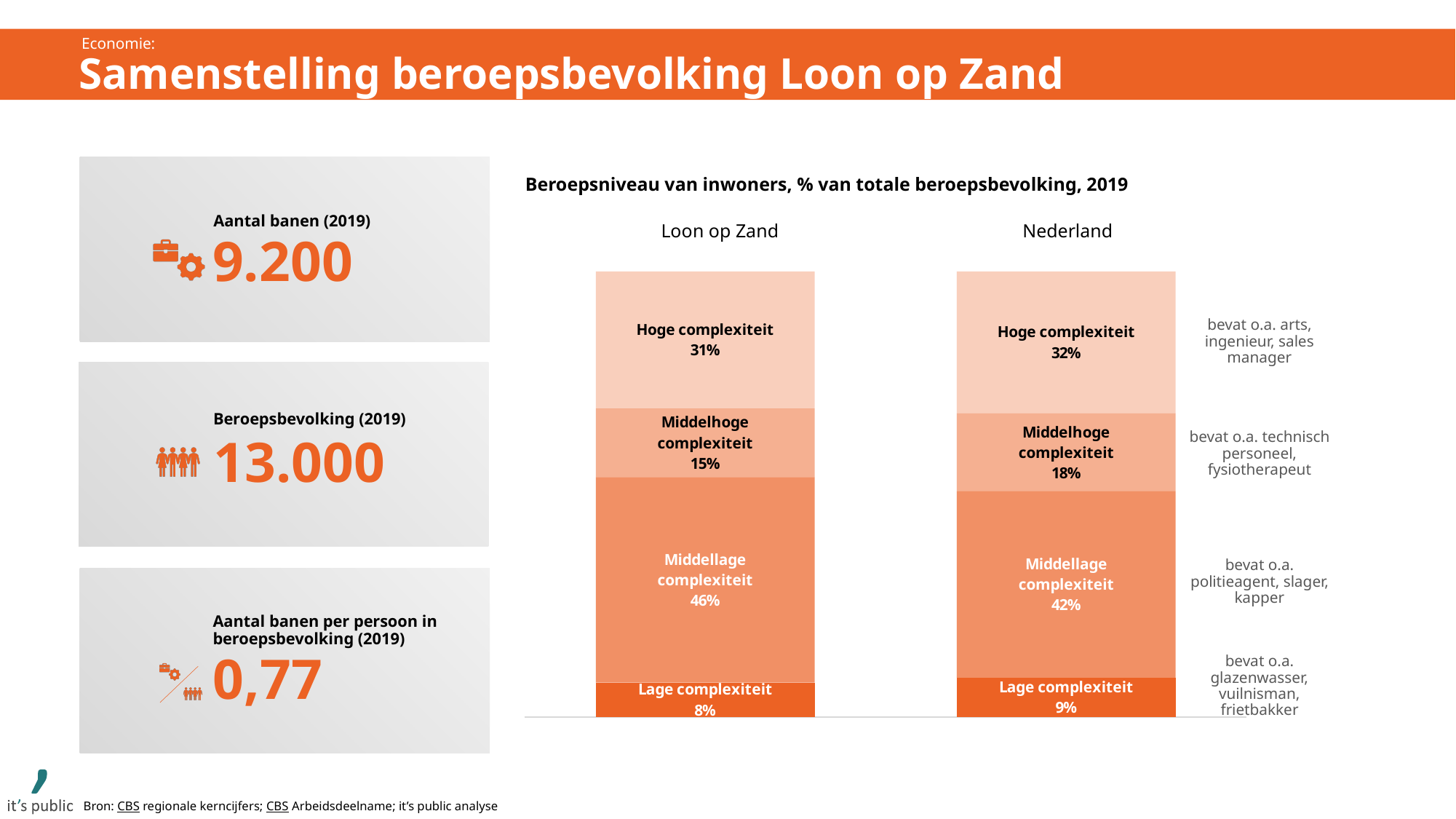
Which has a larger share of 'Middelhoge complexiteit': Loon op Zand or Nederland? Nederland How many bars are shown in the chart? 2 What is the share of 'Middelhoge complexiteit' for Nederland? 18% Which segment is the largest in the Loon op Zand bar? Middellage complexiteit Which segment is the smallest in the Nederland bar? Lage complexiteit What is the difference between the 'Middellage complexiteit' shares of Loon op Zand and Nederland? 4 percentage points What is the total of the segments in the Loon op Zand bar? 100% What is the share of 'Hoge complexiteit' for Loon op Zand? 31% What kind of chart is shown under the title 'Beroepsniveau van inwoners, % van totale beroepsbevolking, 2019'? Stacked bar chart How many segments does each stacked bar contain? 4 What is the share of 'Middellage complexiteit' for Nederland? 42% What is the share of 'Lage complexiteit' for Loon op Zand? 8%